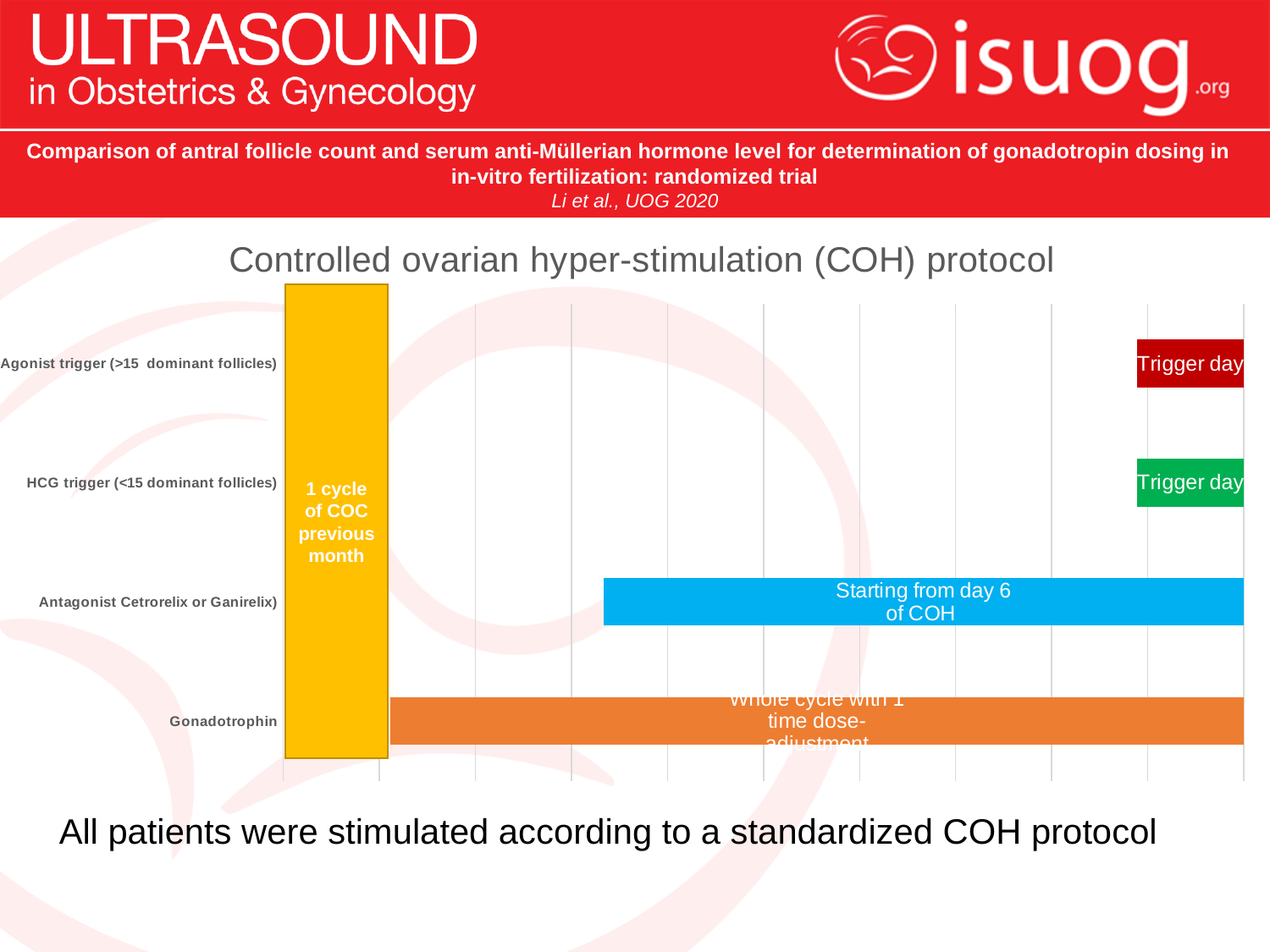
Is the bar for Antagonist Cetrorelix or Ganirelix longer or shorter than the bar for HCG trigger (<15 dominant follicles)? Longer Is the bar for Gonadotrophin longer or shorter than the bar for Antagonist Cetrorelix or Ganirelix? Longer What text is written on the bar for Agonist trigger (>15 dominant follicles)? Trigger day What colour is the bar for HCG trigger (<15 dominant follicles)? Green What is the title of the chart? Controlled ovarian hyper-stimulation (COH) protocol What kind of chart is shown on the slide? Bar chart What text is written on the bar for Gonadotrophin? Whole cycle with 1 time dose-adjustment How many categories are listed on the vertical axis of the chart? 4 What does the yellow block at the left of the chart say? 1 cycle of COC previous month What text is written on the bar for Antagonist Cetrorelix or Ganirelix? Starting from day 6 of COH Which category's bar starts furthest to the left in the chart? Gonadotrophin Which category has the longest bar in the chart? Gonadotrophin